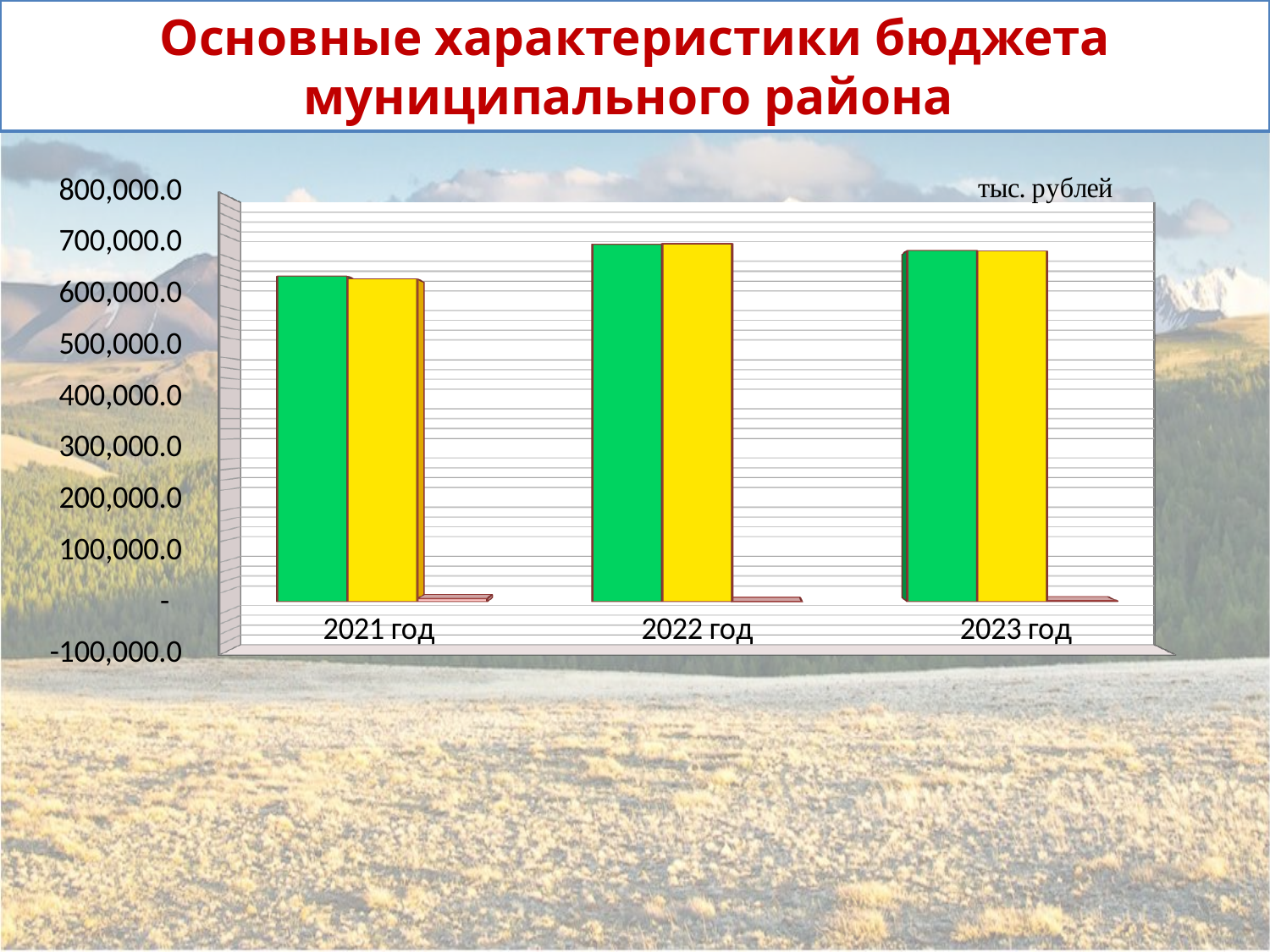
Is the value of the green bar for 2022 год greater or less than 600,000.0? greater Is the value of the yellow bar for 2023 год greater or less than 700,000.0? less Is the value of the small red bar for 2021 год greater or less than 100,000.0? less Is the green bar for 2021 год larger or smaller than the green bar for 2022 год? smaller What unit label is printed in the top right corner of the chart? тыс. рублей Which year has the lowest yellow bar? 2021 год What is the title of the slide containing the chart? Основные характеристики бюджета муниципального района How many year categories are shown on the x axis of the chart? 3 What kind of chart is shown on the slide? bar chart Which year has the lowest green bar? 2021 год Is the yellow bar for 2022 год larger or smaller than the yellow bar for 2021 год? larger